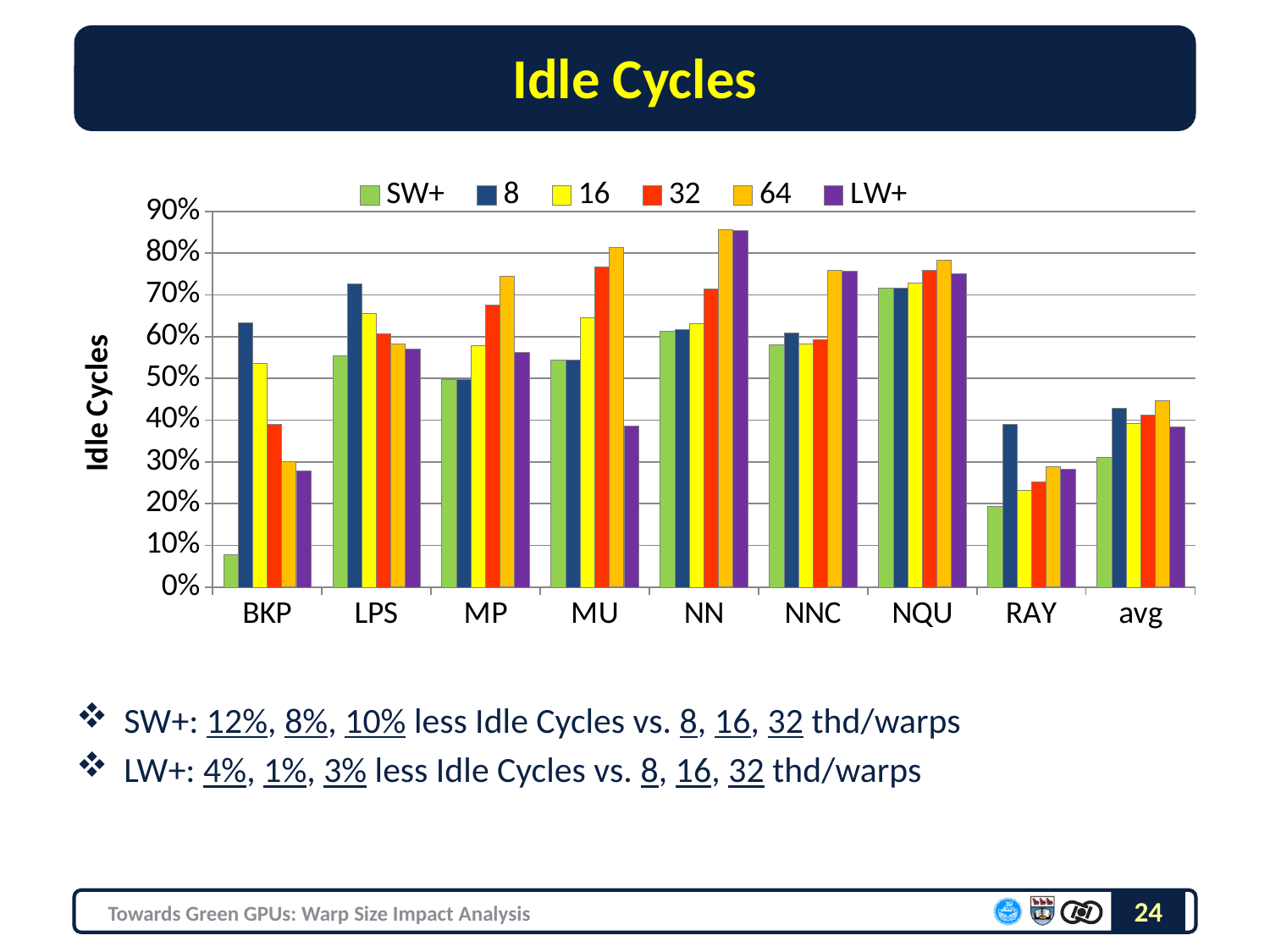
What is the title of the y axis? Idle Cycles For RAY, which is larger: the 8 value or the SW+ value? 8 What kind of chart is shown on the slide? bar chart Is the 64 value for MU greater or less than 70%? greater How many categories are shown along the x axis? 9 Is the 8 value for LPS greater or less than 60%? greater Is the SW+ value for BKP greater or less than 10%? less Which category has the lowest SW+ value? BKP Which series has the highest value for BKP? 8 How many series does the legend list? 6 Which series has the lowest value for MU? LW+